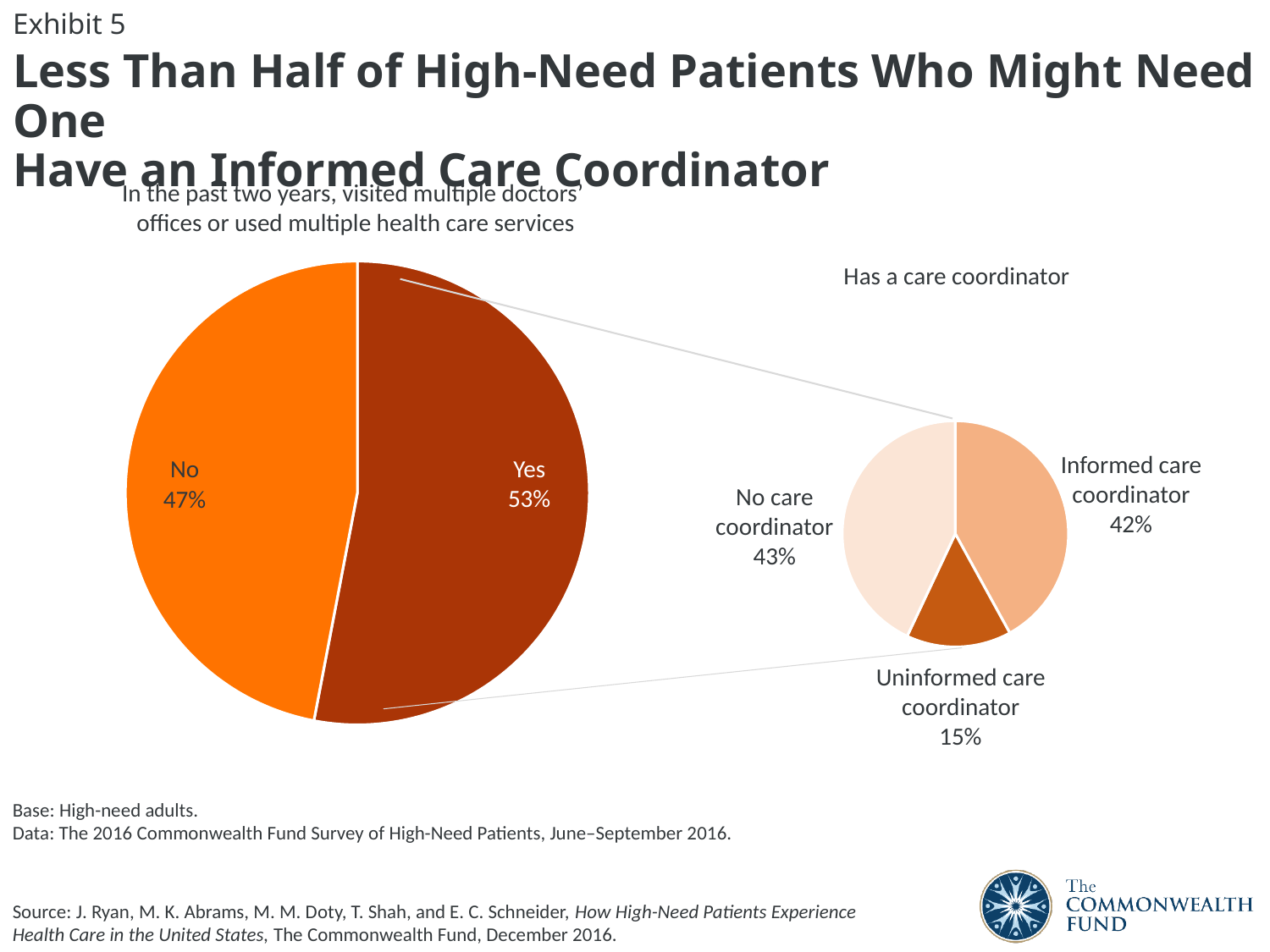
In the right pie chart (Has a care coordinator), which category has the smallest share? Uninformed care coordinator In the left pie chart (visited multiple doctors' offices or used multiple health care services), what share answered No? 47% In the left pie chart (visited multiple doctors' offices or used multiple health care services), which slice is larger, Yes or No? Yes What type of chart is used on the left of the slide? Pie chart In the right pie chart (Has a care coordinator), what share have an uninformed care coordinator? 15% In the right pie chart (Has a care coordinator), what share have no care coordinator? 43% How many slices does the right pie chart (Has a care coordinator) have? 3 In the left pie chart (visited multiple doctors' offices or used multiple health care services), what share of high-need adults answered Yes? 53% What is the title of the right pie chart? Has a care coordinator In the right pie chart (Has a care coordinator), what share have an informed care coordinator? 42% In the left pie chart (visited multiple doctors' offices or used multiple health care services), what is the difference in percentage points between Yes and No? 6 percentage points In the right pie chart (Has a care coordinator), what is the difference in percentage points between the no care coordinator share and the uninformed care coordinator share? 28 percentage points